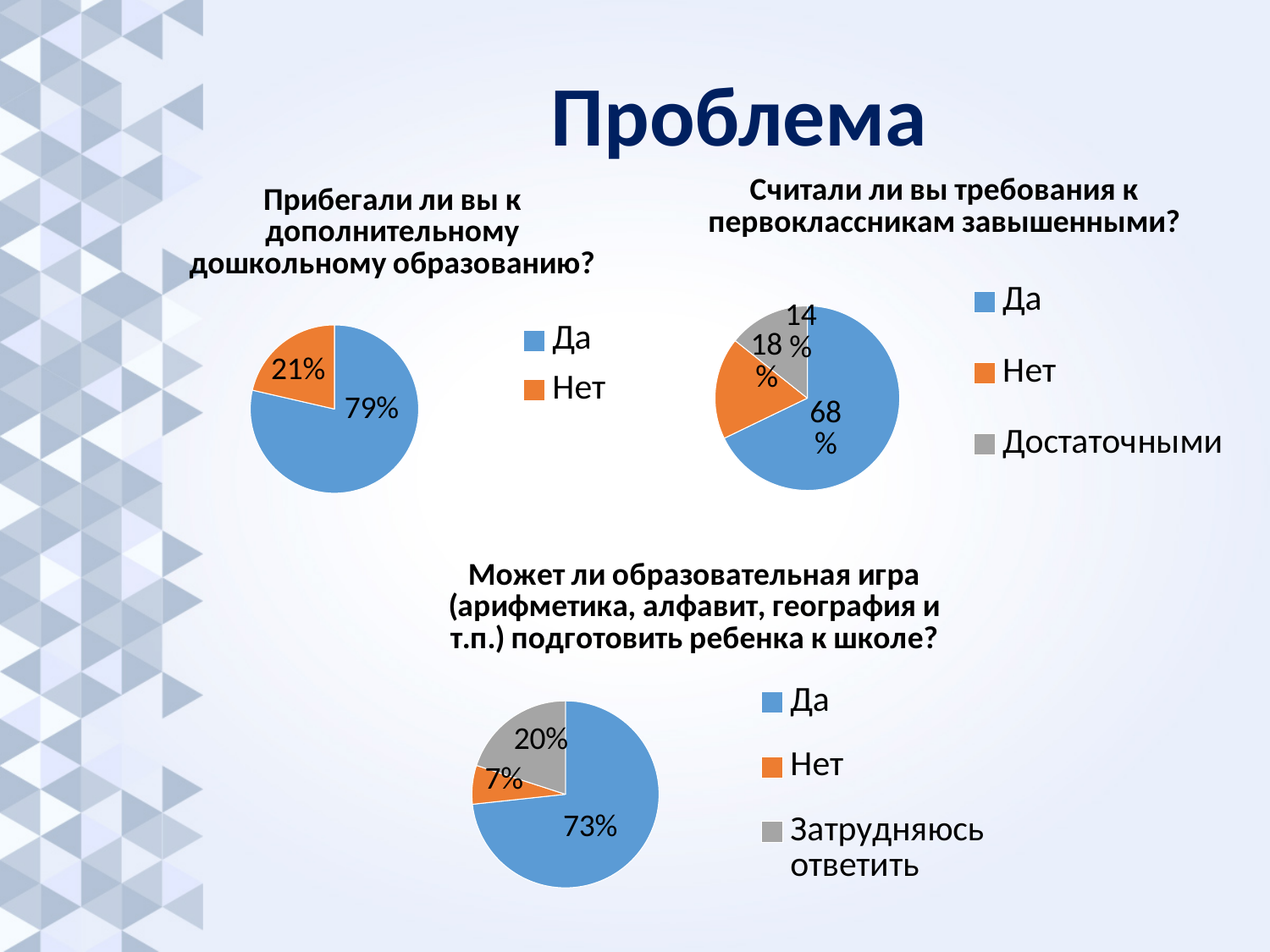
In the top-left pie chart (Прибегали ли вы к дополнительному дошкольному образованию?), what share of respondents answered Да? 79% In the top-right pie chart (Считали ли вы требования к первоклассникам завышенными?), how many entries does the legend list? 3 What type of chart is used for all three charts on the slide? Pie chart In the bottom pie chart (Может ли образовательная игра подготовить ребенка к школе?), what share of respondents answered Нет? 7% In the bottom pie chart (Может ли образовательная игра подготовить ребенка к школе?), what share of respondents answered Затрудняюсь ответить? 20% In the bottom pie chart (Может ли образовательная игра подготовить ребенка к школе?), which is larger: the Нет slice or the Затрудняюсь ответить slice? Затрудняюсь ответить In the top-right pie chart (Считали ли вы требования к первоклассникам завышенными?), what share of respondents answered Достаточными? 14% In the bottom pie chart (Может ли образовательная игра подготовить ребенка к школе?), which answer has the largest slice? Да In the top-left pie chart (Прибегали ли вы к дополнительному дошкольному образованию?), what share of respondents answered Нет? 21% In the top-left pie chart (Прибегали ли вы к дополнительному дошкольному образованию?), what is the difference between the Да and Нет shares? 58% In the top-right pie chart (Считали ли вы требования к первоклассникам завышенными?), what share of respondents answered Да? 68% In the top-right pie chart (Считали ли вы требования к первоклассникам завышенными?), which answer has the smallest slice? Достаточными